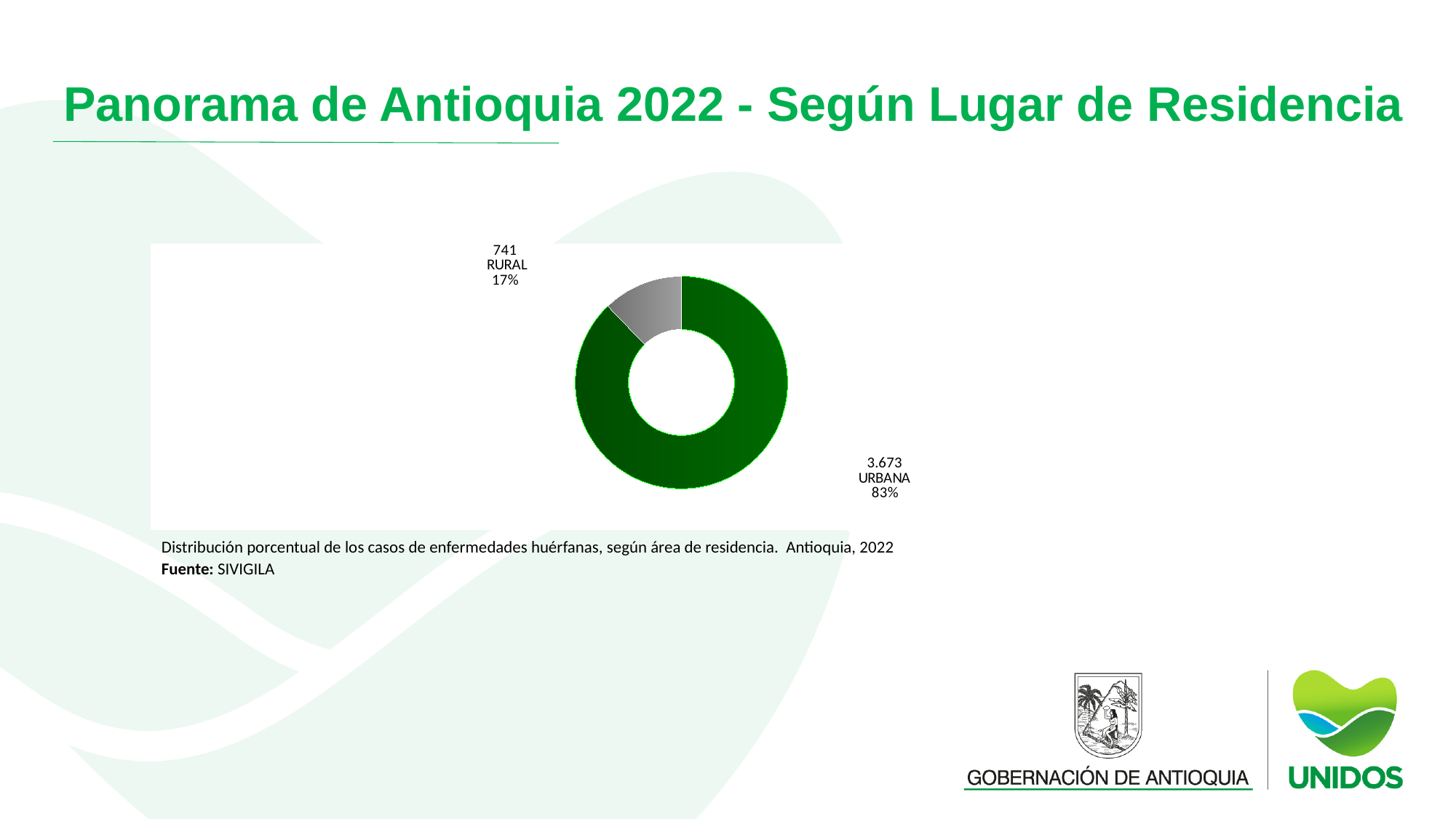
How many cases are shown for URBANA? 3.673 Which area of residence has the lowest number of cases? RURAL How many cases are shown for RURAL? 741 Which has more cases, URBANA or RURAL? URBANA Which area of residence has the highest number of cases? URBANA What is the difference in cases between URBANA and RURAL? 2.932 How many categories (slices) does the chart show? 2 What is the total number of cases across both slices? 4.414 What percentage share does the RURAL slice represent? 17% What colour is the RURAL slice? Grey What percentage share does the URBANA slice represent? 83% What kind of chart is shown on the slide? Doughnut (pie) chart